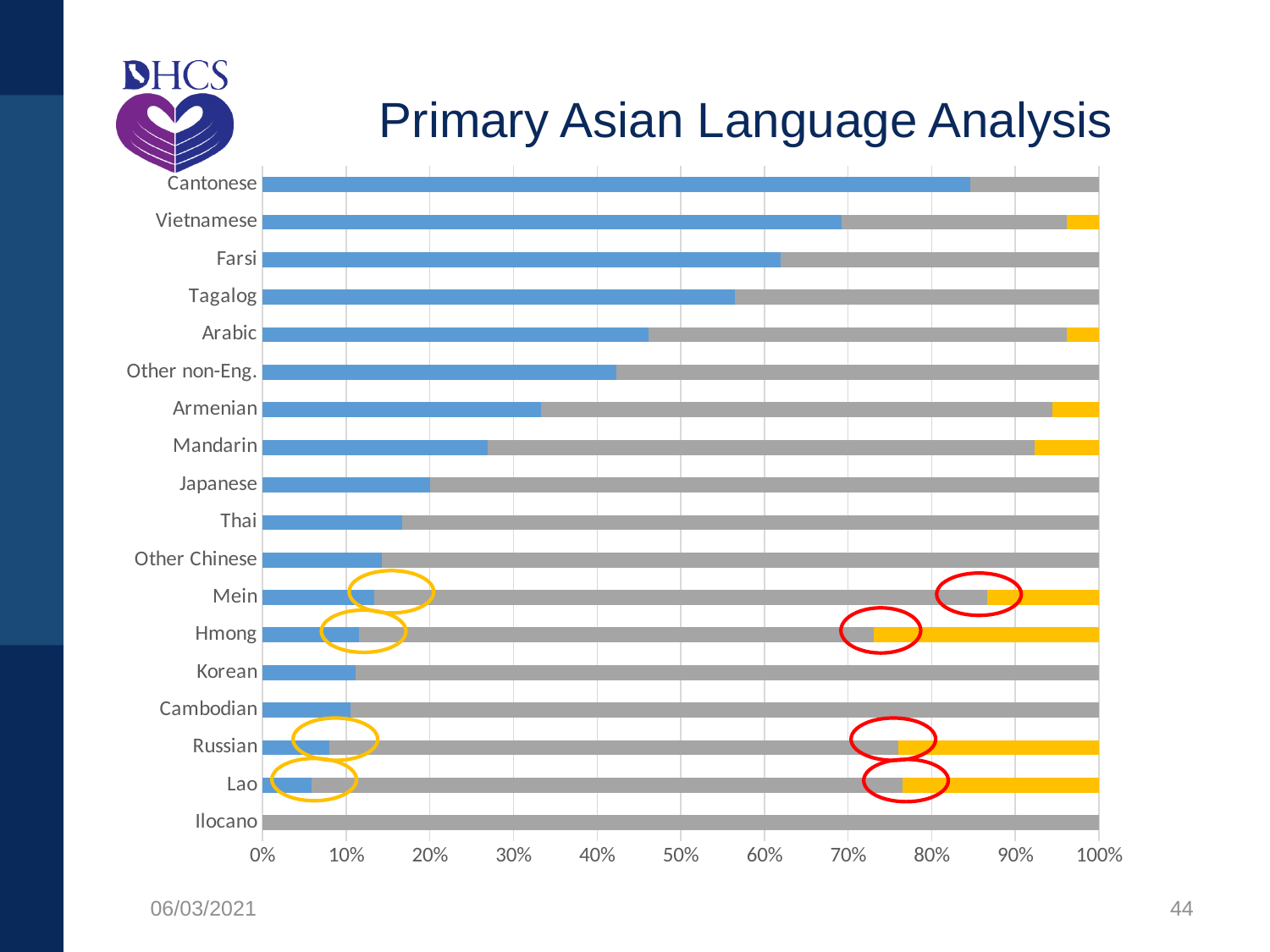
How many languages are listed on the chart? 18 Which has a longer yellow segment, Hmong or Mein? Hmong Which language has the longest blue segment? Cantonese Is the blue segment for Cantonese greater or less than 80%? greater Which language has no blue segment at all? Ilocano Is the blue segment for Tagalog greater or less than 50%? greater What is the title of the chart? Primary Asian Language Analysis What type of chart is shown on the slide? bar chart Which has a longer blue segment, Vietnamese or Farsi? Vietnamese Do the blue segments get longer or shorter going from the top of the chart to the bottom? shorter Is the blue segment for Japanese greater or less than 30%? less